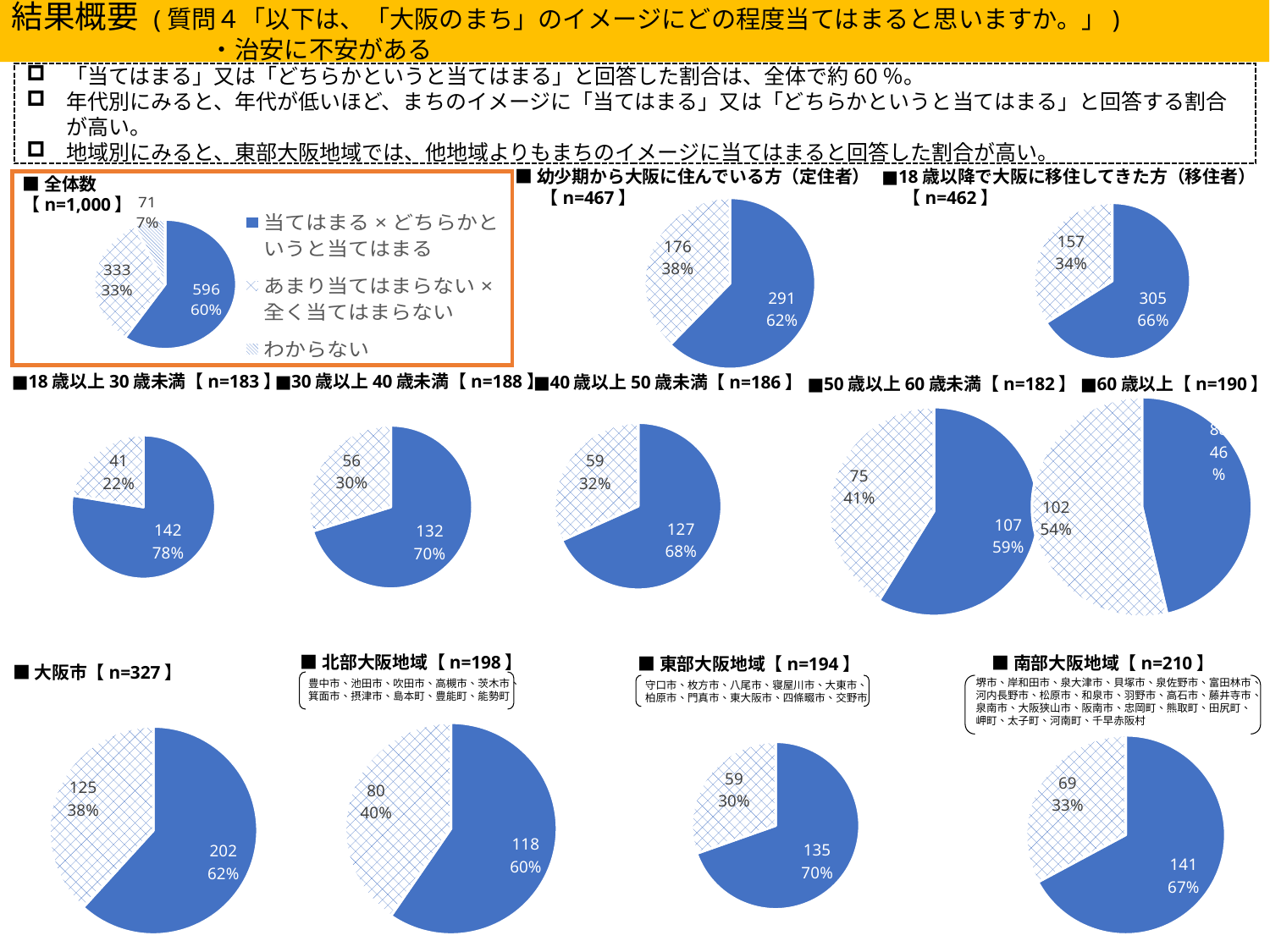
このスライドのグラフはどの種類のグラフですか。 円グラフ 「南部大阪地域【n=210】」の円グラフで、網掛け部分の回答数と割合はいくつですか。 69、33% 年代別の5つの円グラフのうち、青色の部分の割合が最も高いのはどの年代ですか。 18歳以上30歳未満 「18歳以降で大阪に移住してきた方（移住者）【n=462】」の円グラフで、青色の部分の回答数と割合はいくつですか。 305、66% 「東部大阪地域【n=194】」と「北部大阪地域【n=198】」の円グラフでは、青色の部分の割合はどちらが大きいですか。 東部大阪地域 「全体数【n=1,000】」の円グラフの凡例には、いくつの項目がありますか。 3 「全体数【n=1,000】」の円グラフで、「当てはまる×どちらかというと当てはまる」の割合はいくつですか。 60% 「全体数【n=1,000】」の円グラフで、「わからない」の回答数はいくつですか。 71 「50歳以上60歳未満【n=182】」の円グラフで、網掛け部分の割合はいくつですか。 41% 「大阪市【n=327】」の円グラフで、青色の部分の回答数はいくつですか。 202 「幼少期から大阪に住んでいる方（定住者）【n=467】」の円グラフで、網掛け部分の割合はいくつですか。 38% 「18歳以上30歳未満【n=183】」の円グラフで、青色の部分と網掛け部分の回答数の差はいくつですか。 101